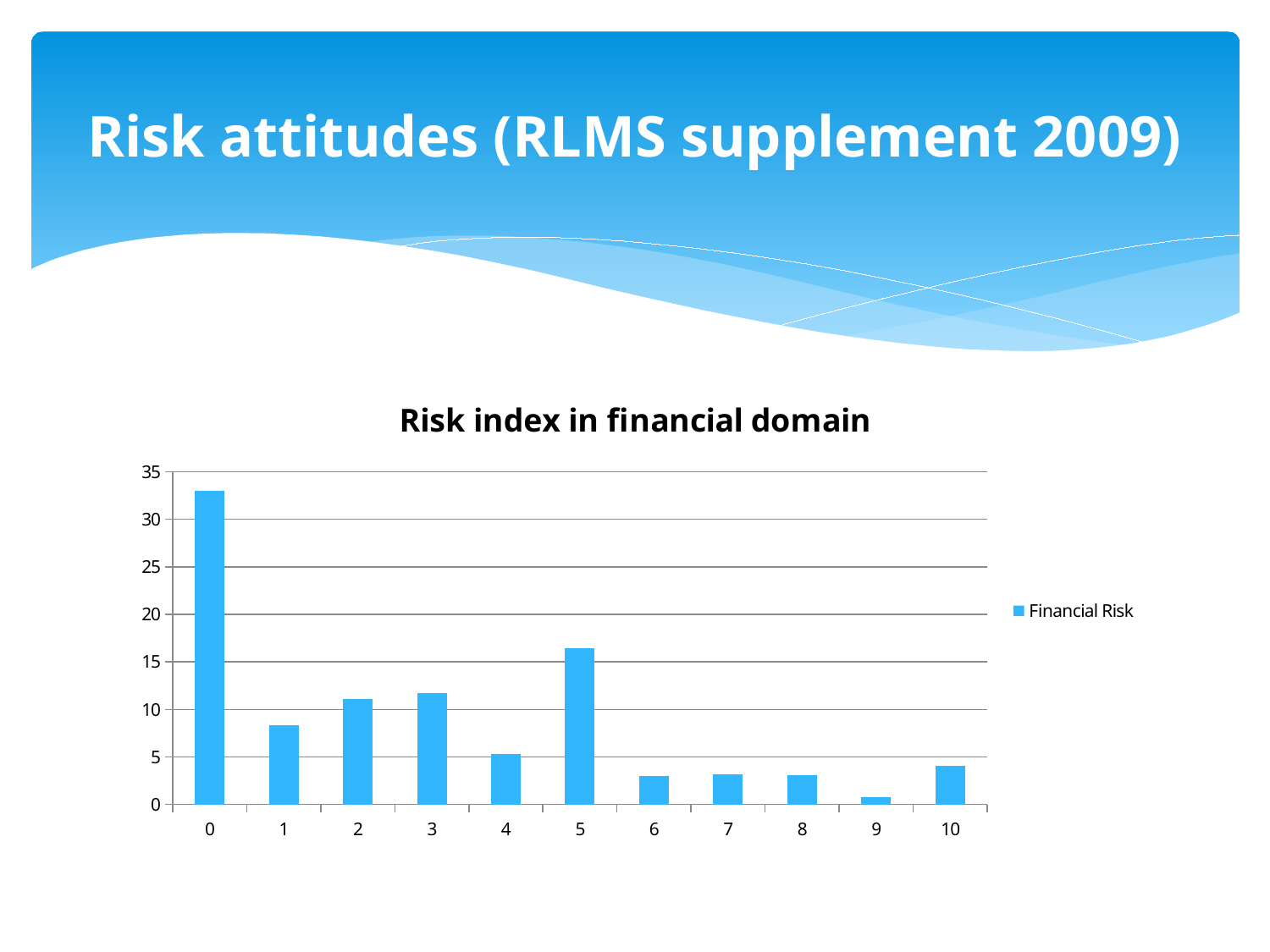
Which category has the lowest value? 9 How many series does the legend list? 1 Is the value for category 5 greater or less than 15? greater Is the value for category 0 greater or less than 30? greater Is the value for category 4 greater or less than 10? less Which has a larger value, category 10 or category 9? 10 Which has a larger value, category 5 or category 1? 5 What type of chart is shown on the slide? bar chart Which category has the highest value? 0 What is the name of the series shown in the legend? Financial Risk How many categories are shown on the x axis? 11 What is the title of the chart? Risk index in financial domain